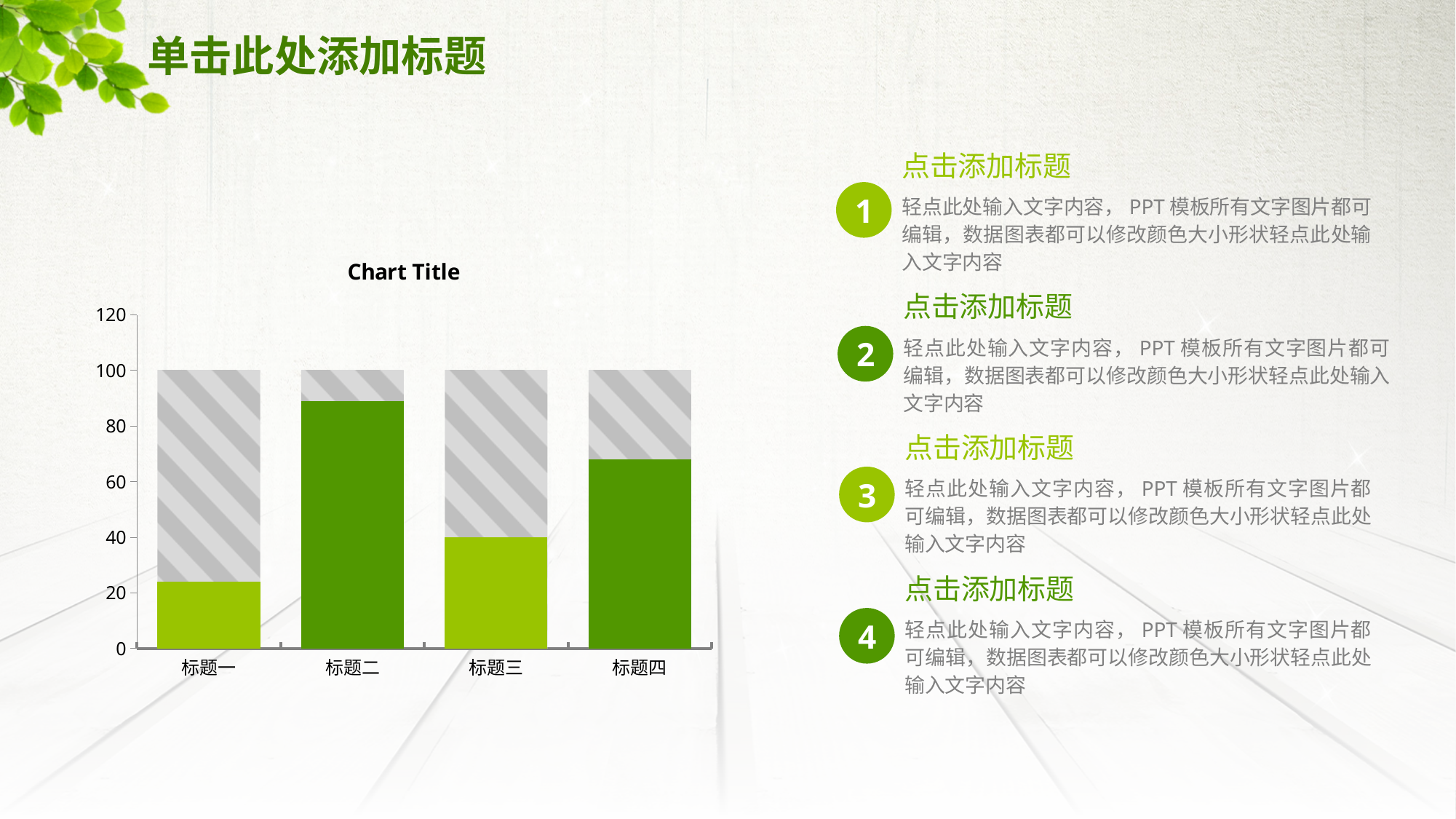
Is the green segment for 标题四 greater or less than 60? greater What is the title of the chart? Chart Title Is the green segment for 标题三 greater or less than 60? less Which has the larger green segment, 标题四 or 标题一? 标题四 Which has the larger green segment, 标题二 or 标题三? 标题二 Is the green segment for 标题一 greater or less than 40? less Which category has the shortest green (solid) segment? 标题一 How many categories are shown on the x axis of the chart? 4 What kind of chart is shown on the slide? bar chart Which category has the tallest green (solid) segment? 标题二 What is the total height of the stacked bar for 标题一? 100